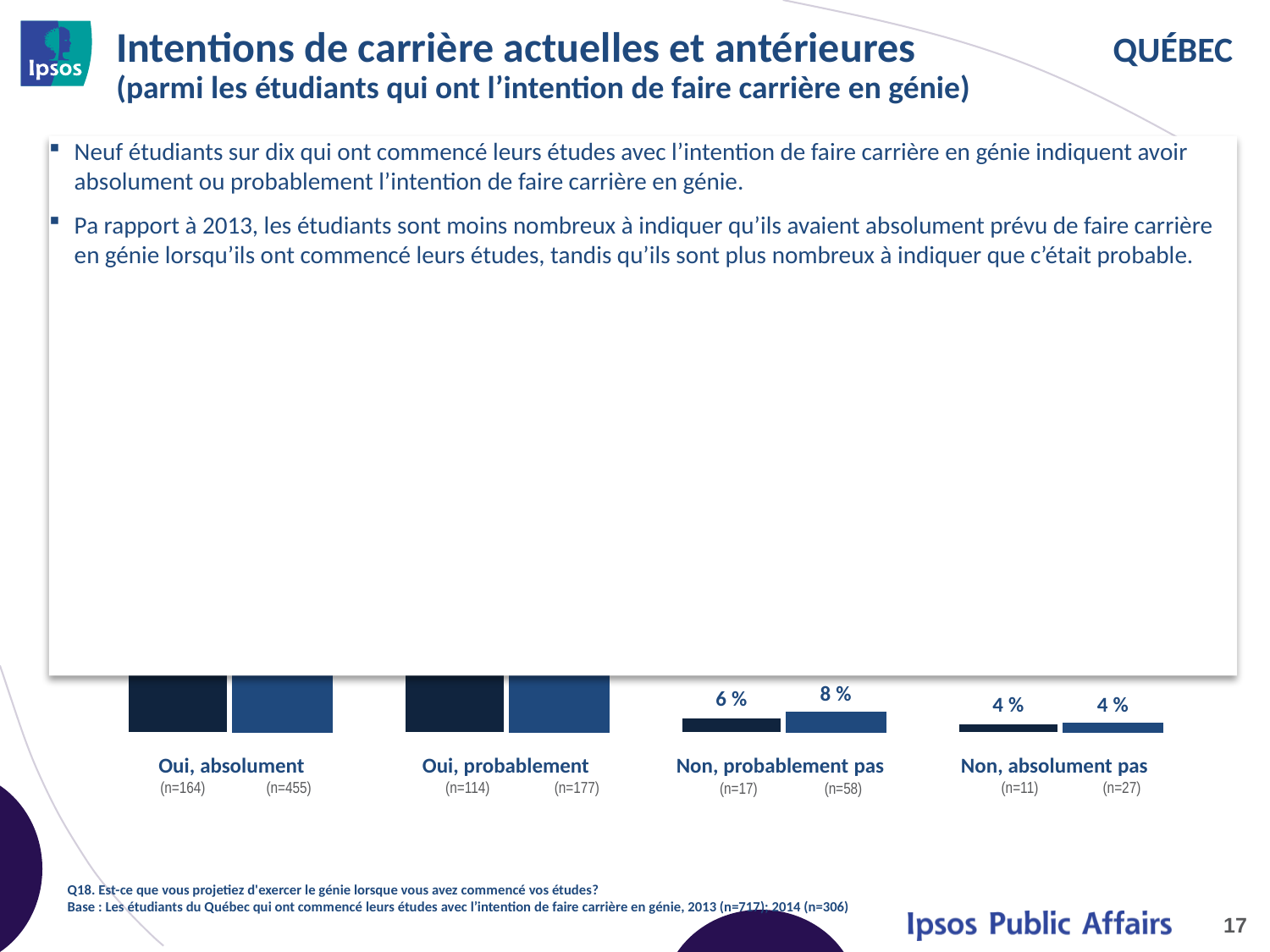
What is the value of the lighter blue (right) bar for 'Non, absolument pas'? 4 % What is the sample size (n) shown under the lighter blue (right) bar for 'Oui, probablement'? n=177 For 'Non, probablement pas', which bar is larger, the dark (left) bar or the lighter blue (right) bar? the lighter blue (right) bar What is the sample size (n) shown under the dark (left) bar for 'Oui, absolument'? n=164 What is the value of the dark (left) bar for 'Non, probablement pas'? 6 % What is the value of the lighter blue (right) bar for 'Non, probablement pas'? 8 % What is the difference between the two bars for 'Non, probablement pas'? 2 % What is the value of the dark (left) bar for 'Non, absolument pas'? 4 % How many categories are shown along the x axis of the chart? 4 What kind of chart is shown on the slide? bar chart Which category has the lowest values in the chart? Non, absolument pas How many bars are plotted for each category in the chart? 2